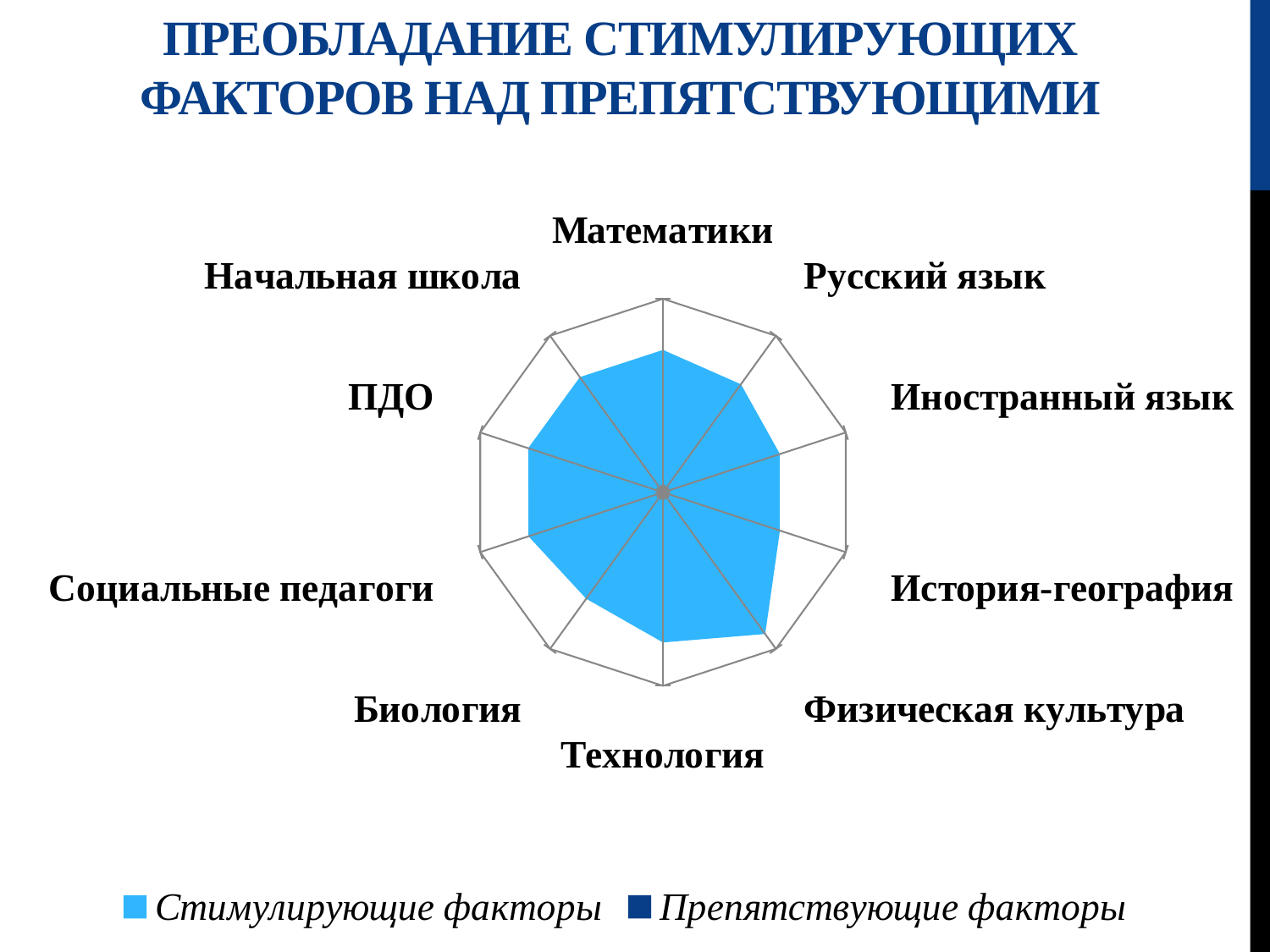
Which is larger for Стимулирующие факторы: Физическая культура or Русский язык? Физическая культура Which is larger for Стимулирующие факторы: Физическая культура or История-география? Физическая культура How many categories (axes) does the radar chart have? 10 Which category has the highest value for Стимулирующие факторы? Физическая культура What colour is used for the Стимулирующие факторы series? Light blue Which is larger for Стимулирующие факторы: Технология or Иностранный язык? Технология Which category is positioned at the top of the radar chart? Математики How many series does the legend list? 2 What are the two series named in the legend? Стимулирующие факторы and Препятствующие факторы What kind of chart is shown on the slide? Radar chart